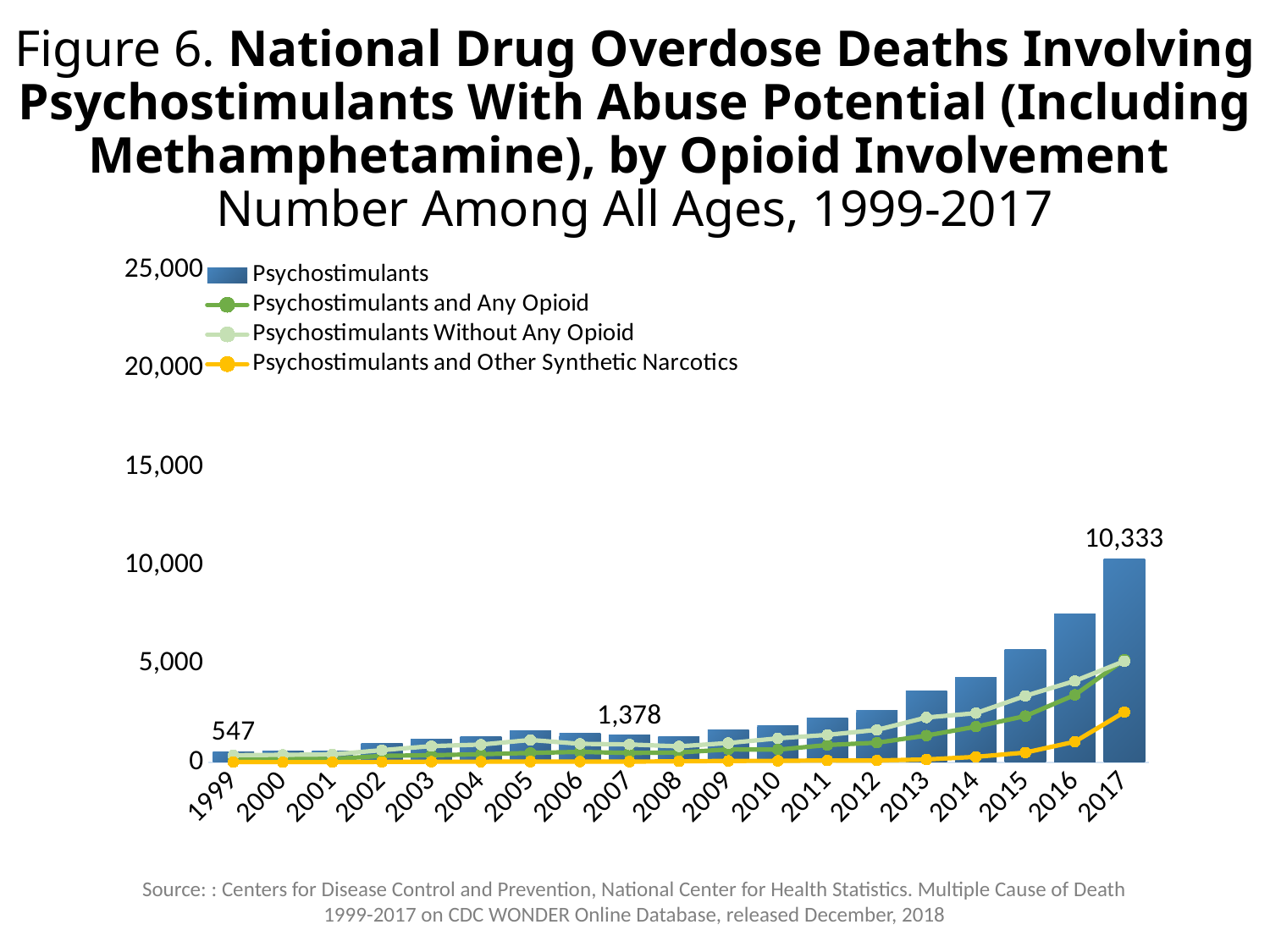
Do the Psychostimulants values generally rise or fall from 1999 to 2017? rise Is the Psychostimulants bar for 2014 greater or less than 5,000? less Is the Psychostimulants bar for 2016 greater or less than 5,000? greater How many years are shown on the x axis? 19 Which year has the larger Psychostimulants bar, 2016 or 2017? 2017 How many series does the legend list? 4 What is the value of the Psychostimulants bar for 2017? 10,333 What is the difference between the Psychostimulants values for 2017 and 1999? 9,786 What is the value of the Psychostimulants bar for 2007? 1,378 What is the difference between the Psychostimulants values for 2017 and 2007? 8,955 What is the value of the Psychostimulants bar for 1999? 547 Which year has the highest Psychostimulants bar? 2017